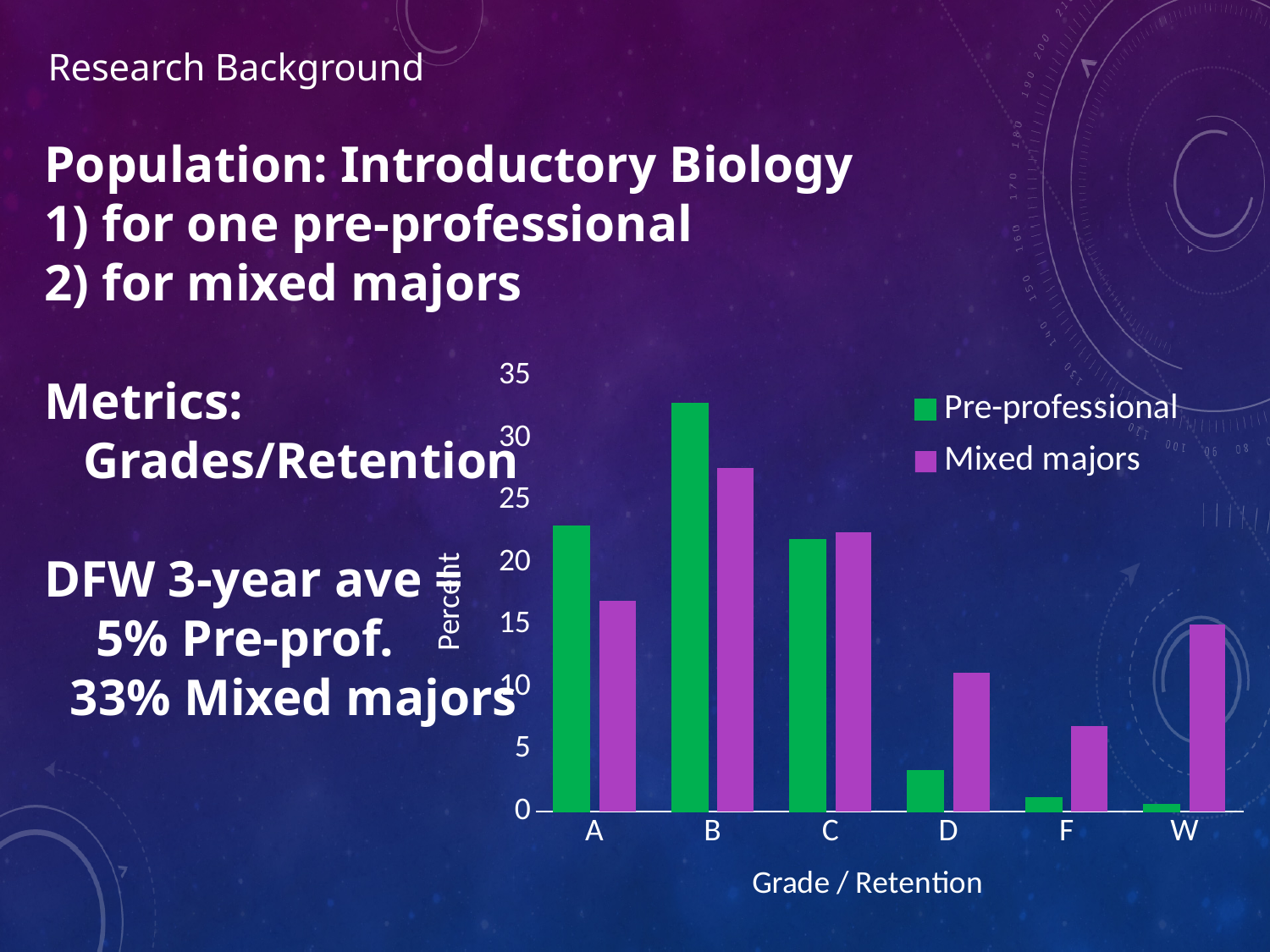
Is the Mixed majors value for W greater or less than 20? less For grade D, which series has the larger value, Pre-professional or Mixed majors? Mixed majors What kind of chart is shown on the slide? bar chart For grade A, which series has the larger value, Pre-professional or Mixed majors? Pre-professional Is the Pre-professional value for grade B greater or less than 30? greater Which category has the lowest value for the Pre-professional series? W Which category has the highest value for the Mixed majors series? B How many series does the chart's legend list? 2 Which category has the highest value for the Pre-professional series? B How many categories are shown on the x axis of the chart? 6 Which category has the lowest value for the Mixed majors series? F What is the label of the chart's x axis? Grade / Retention